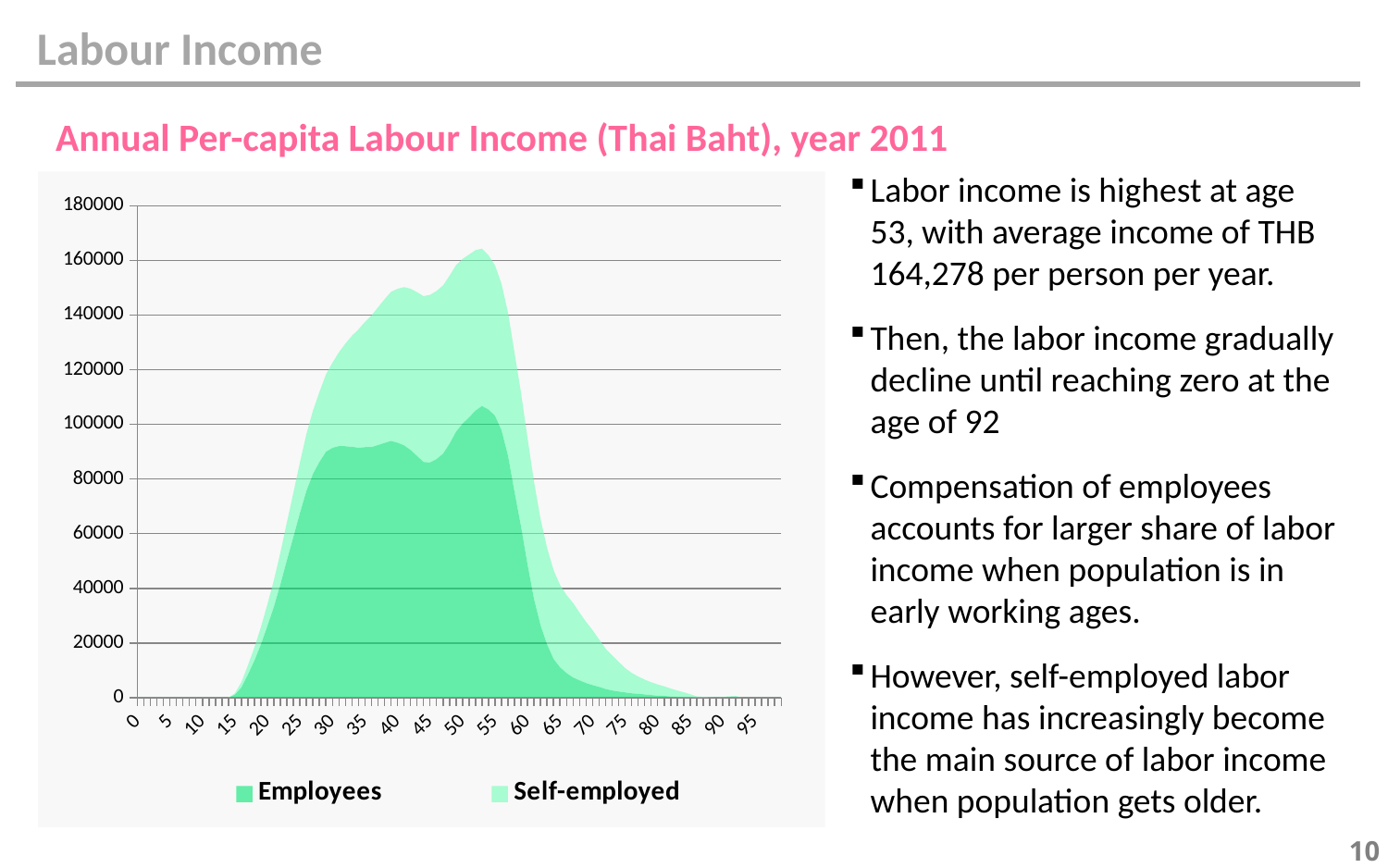
How many series does the chart's legend list? 2 At age 70, which series has the larger value, Employees or Self-employed? Self-employed At age 40, which series has the larger value, Employees or Self-employed? Employees Is the value for Employees at age 65 greater or less than 20000? less Is the total labour income at age 40 greater or less than 140000? greater Do the total labour income values rise or fall as age increases from 55 to 90? fall Is the value for Employees at age 40 greater or less than 80000? greater What is the title of the chart? Annual Per-capita Labour Income (Thai Baht), year 2011 What are the two series named in the chart's legend? Employees and Self-employed How many age labels are shown on the x axis? 20 What kind of chart is shown on the slide? Area chart